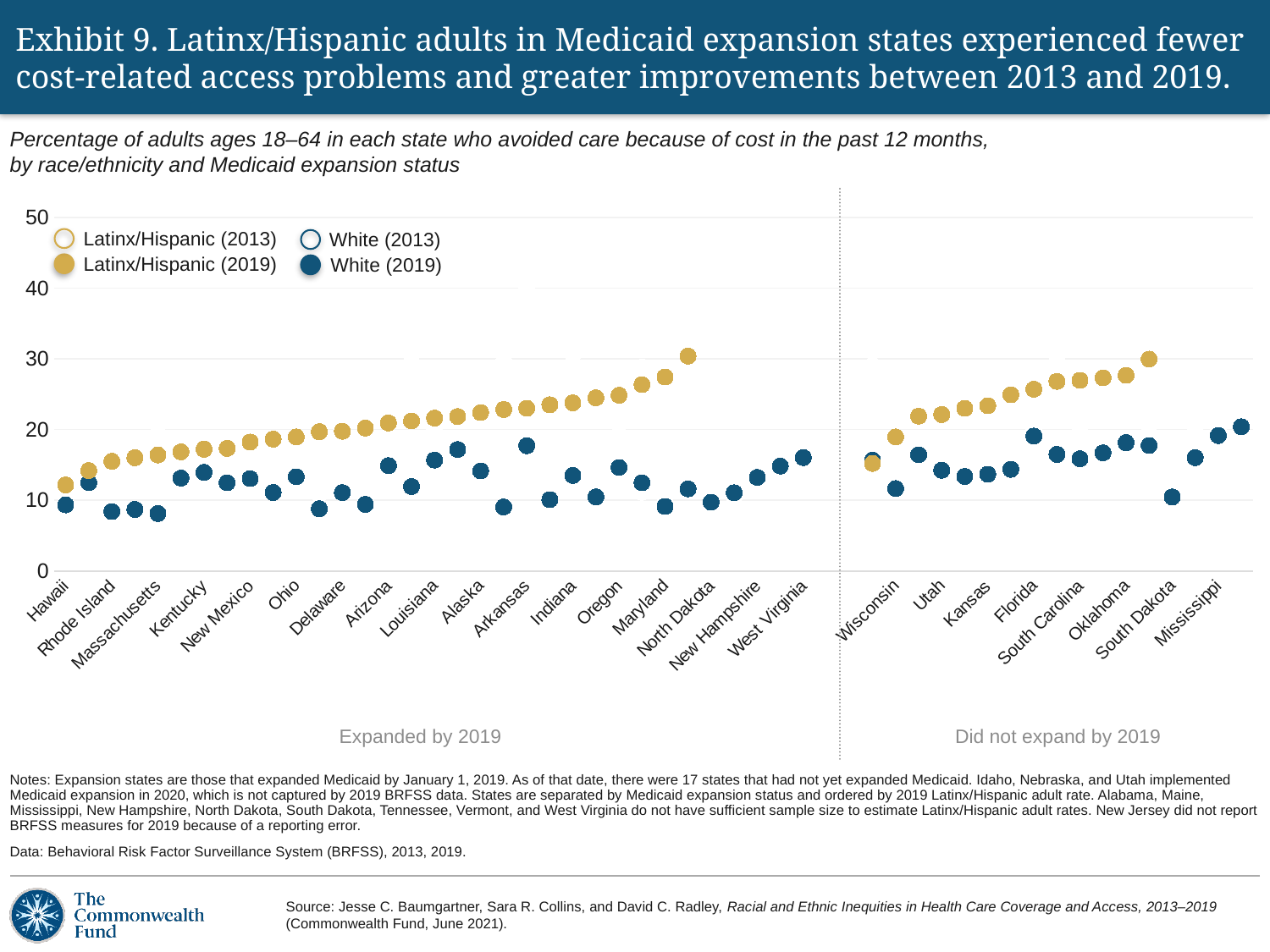
Is the Latinx/Hispanic (2019) value for Wisconsin greater or less than 20? less Is the White (2019) value for Mississippi greater or less than 10? greater Is the Latinx/Hispanic (2019) value for Hawaii greater or less than 10? greater For Wisconsin, which is larger: the Latinx/Hispanic (2019) value or the White (2019) value? Latinx/Hispanic (2019) What are the two Medicaid expansion groups the states are divided into on the chart? Expanded by 2019; Did not expand by 2019 How many series does the chart legend list? 4 Within each expansion group, do the Latinx/Hispanic (2019) values rise or fall from left to right along the x axis? rise What kind of chart is shown on the slide? Scatter (dot) chart For Hawaii, which is larger: the Latinx/Hispanic (2019) value or the White (2019) value? Latinx/Hispanic (2019) Which series are listed in the chart legend? Latinx/Hispanic (2013), Latinx/Hispanic (2019), White (2013), White (2019)